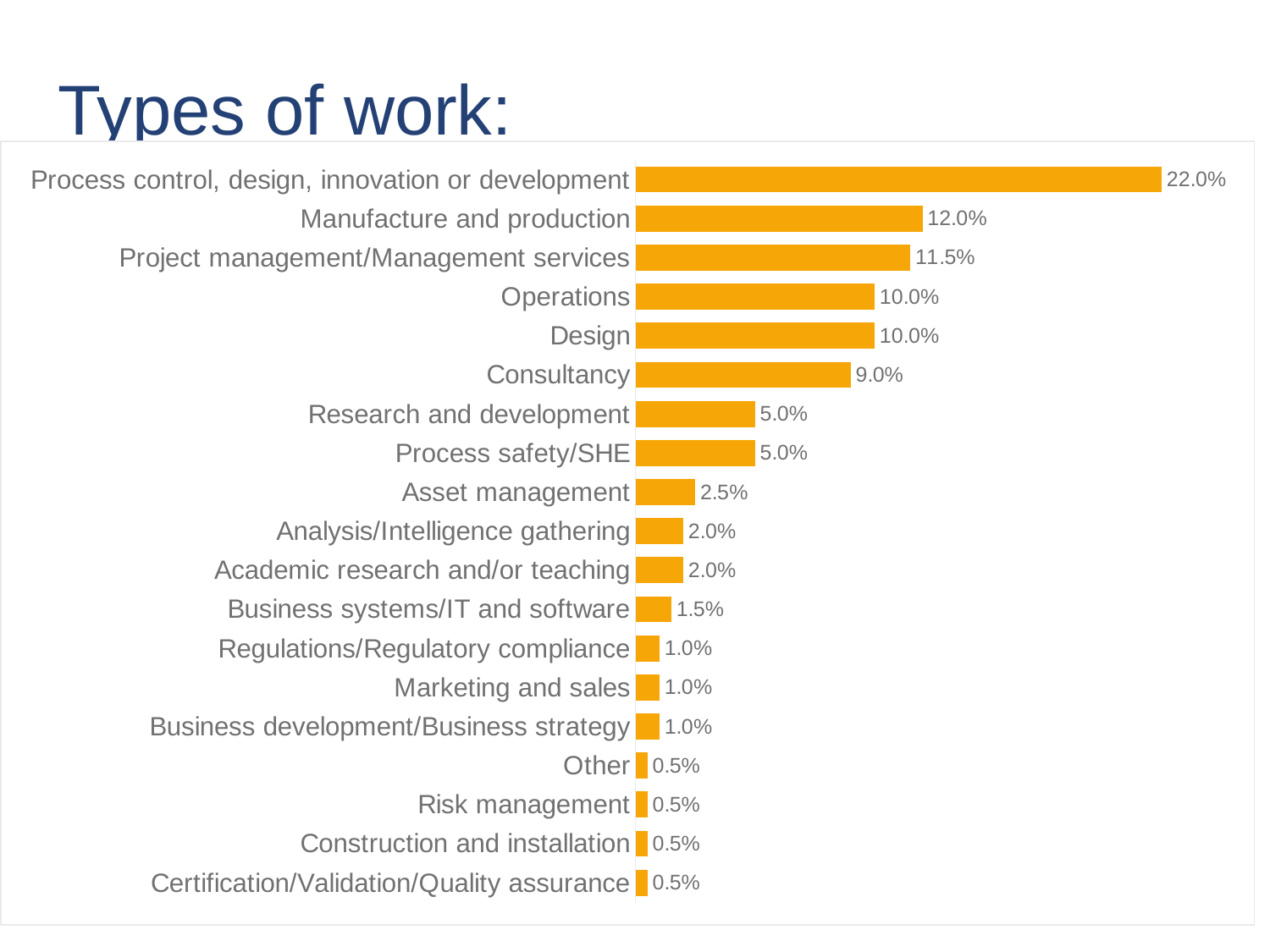
Which is larger, the value for Asset management or the value for Academic research and/or teaching? Asset management What is the value for Business systems/IT and software? 1.5% What is the title of the slide? Types of work: What is the value for Process control, design, innovation or development? 22.0% Which type of work has the highest value? Process control, design, innovation or development What is the value for Asset management? 2.5% What is the difference between Manufacture and production and Project management/Management services? 0.5% What is the difference between Process control, design, innovation or development and Manufacture and production? 10.0% What is the value for Consultancy? 9.0% What kind of chart is shown on the slide? Bar chart Which is larger, the value for Consultancy or the value for Research and development? Consultancy How many types of work are shown in the chart? 19